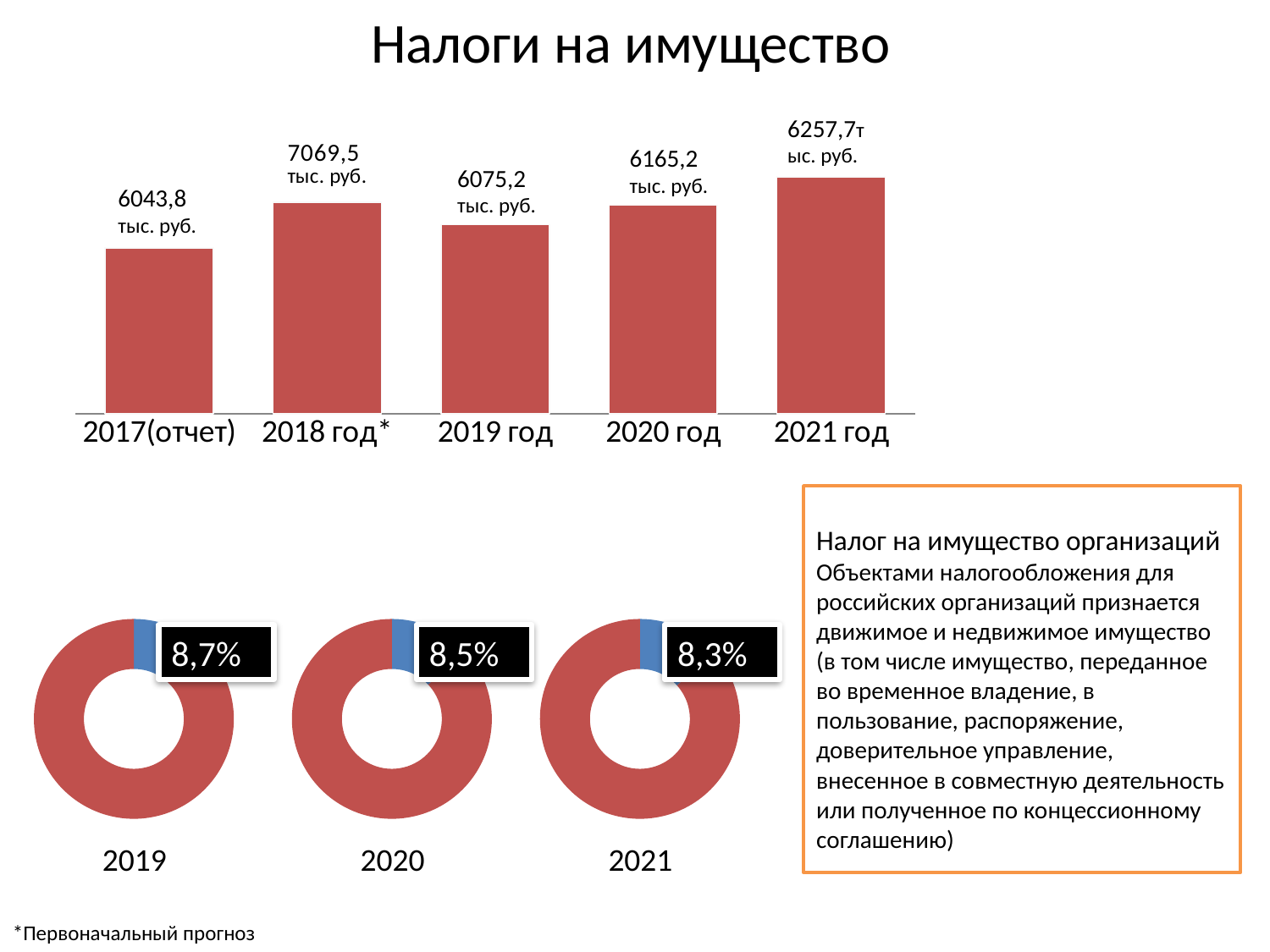
In the bar chart at the top of the slide, what is the value for 2021 год? 6257,7 тыс. руб. In the bar chart at the top of the slide, what is the difference between the values for 2018 год* and 2017(отчет)? 1025,7 тыс. руб. What kind of chart is shown at the top of the slide? Bar chart In the bar chart at the top of the slide, which category has the lowest value? 2017(отчет) How many bars are in the bar chart at the top of the slide? 5 In the bar chart at the top of the slide, what is the difference between the values for 2021 год and 2020 год? 92,5 тыс. руб. In the donut chart labelled 2020 at the bottom of the slide, what percentage is shown? 8,5% Among the three donut charts at the bottom of the slide, which year shows the lowest percentage? 2021 In the bar chart at the top of the slide, which is larger: the value for 2019 год or the value for 2020 год? 2020 год In the bar chart at the top of the slide, what is the value for 2018 год*? 7069,5 тыс. руб. In the bar chart at the top of the slide, what is the value for 2017(отчет)? 6043,8 тыс. руб.